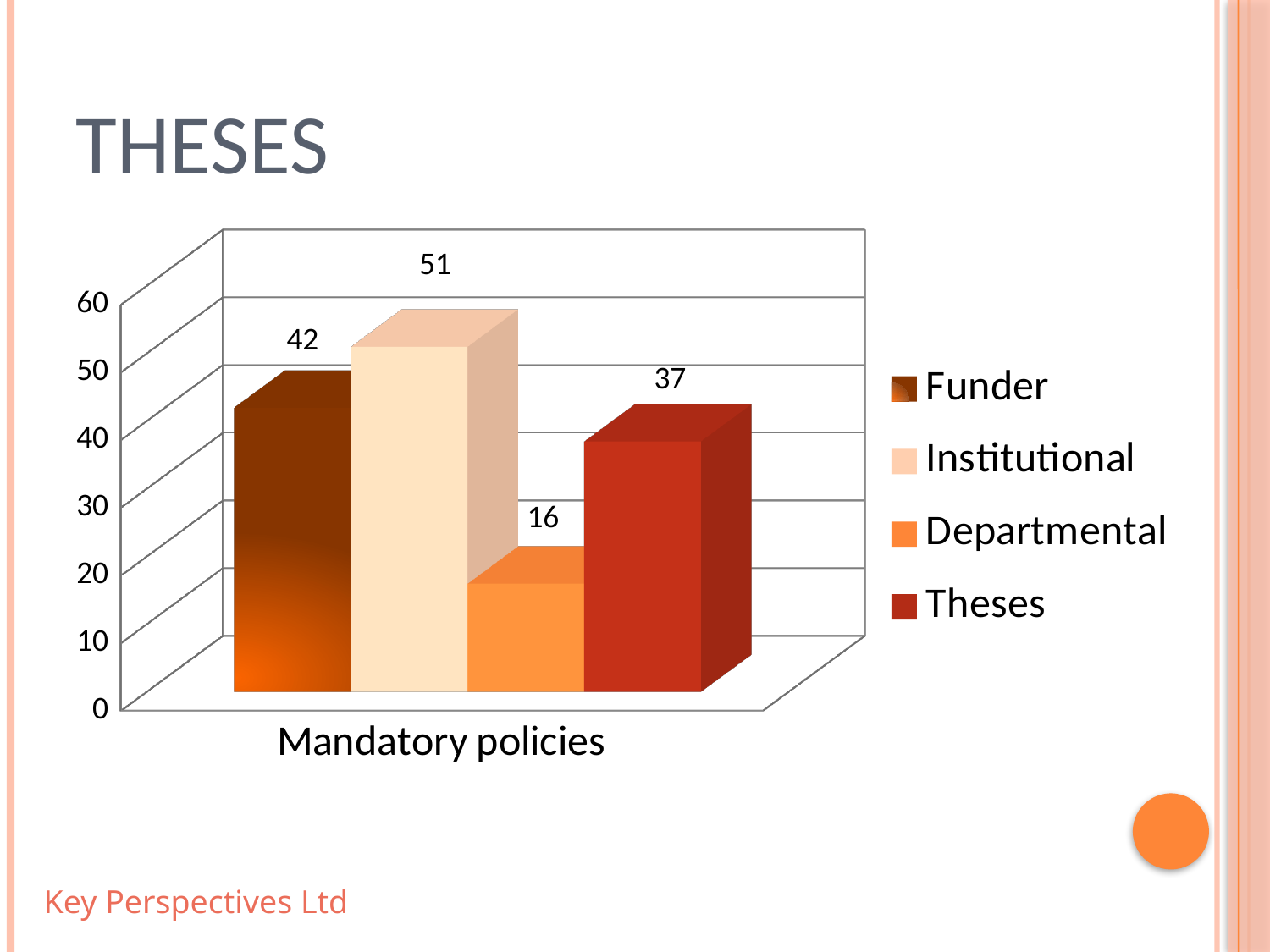
What kind of chart is shown on the slide? Bar chart Which series has the lowest value? Departmental What is the value for Funder in the Mandatory policies chart? 42 What is the difference between the Theses and Departmental values? 21 Which is larger, the value for Funder or the value for Theses? Funder Which series has the highest value? Institutional What is the value for Departmental? 16 What is the label on the x axis of the chart? Mandatory policies What is the difference between the Institutional and Funder values? 9 How many series does the legend list? 4 What is the value for Institutional? 51 What is the value for Theses? 37